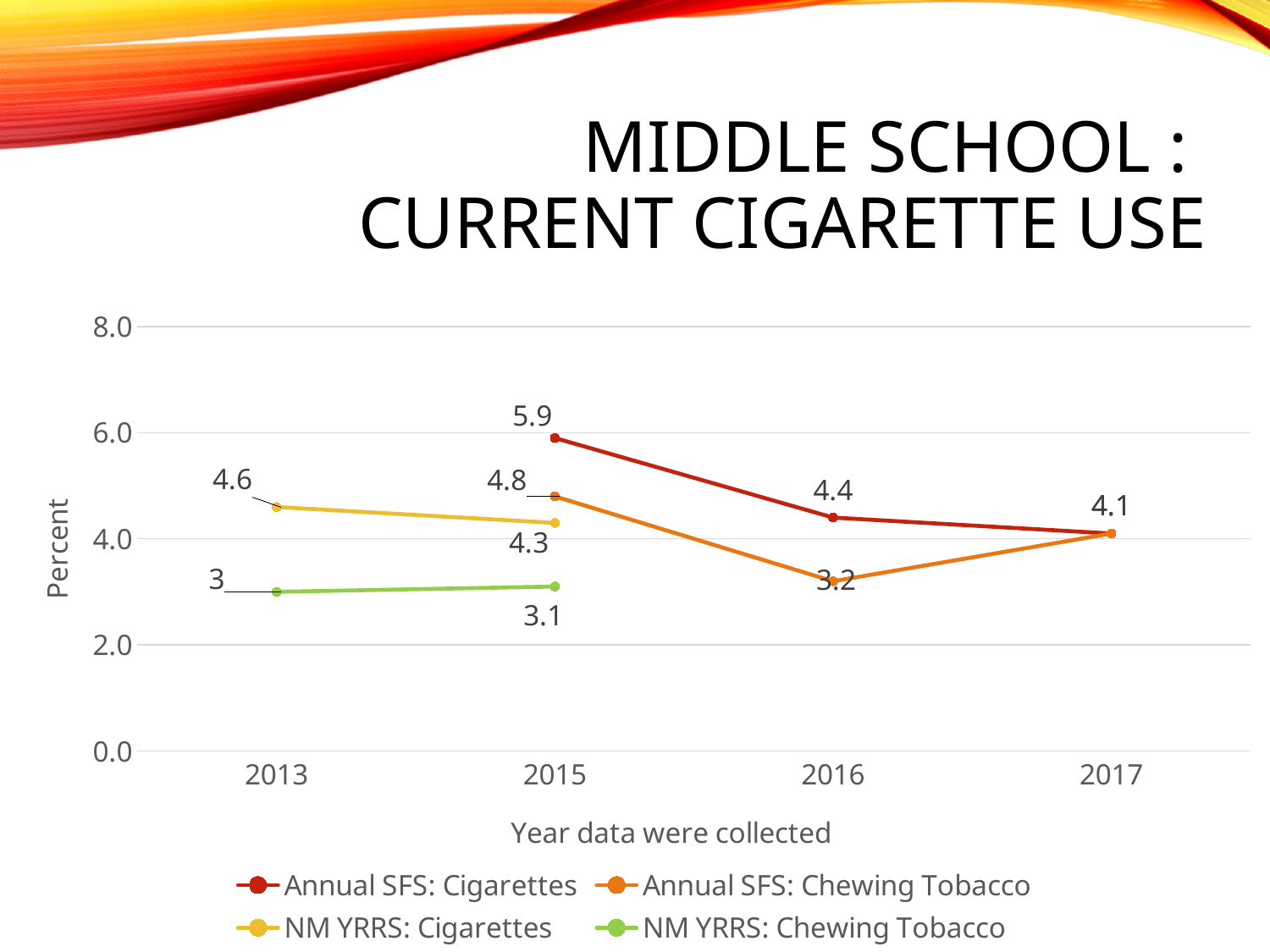
What is the value for Annual SFS: Chewing Tobacco in 2016? 3.2 Which series has the highest plotted value on the chart? Annual SFS: Cigarettes In 2015, which is larger: Annual SFS: Cigarettes or Annual SFS: Chewing Tobacco? Annual SFS: Cigarettes What is the value for Annual SFS: Cigarettes in 2016? 4.4 What is the value for Annual SFS: Cigarettes in 2015? 5.9 What is the value for NM YRRS: Cigarettes in 2013? 4.6 What is the value for Annual SFS: Chewing Tobacco in 2015? 4.8 What kind of chart is shown on the slide? Line chart What is the value for NM YRRS: Chewing Tobacco in 2013? 3 How many years are shown on the x axis? 4 How many series does the legend list? 4 By how much did Annual SFS: Cigarettes fall from 2015 to 2016? 1.5